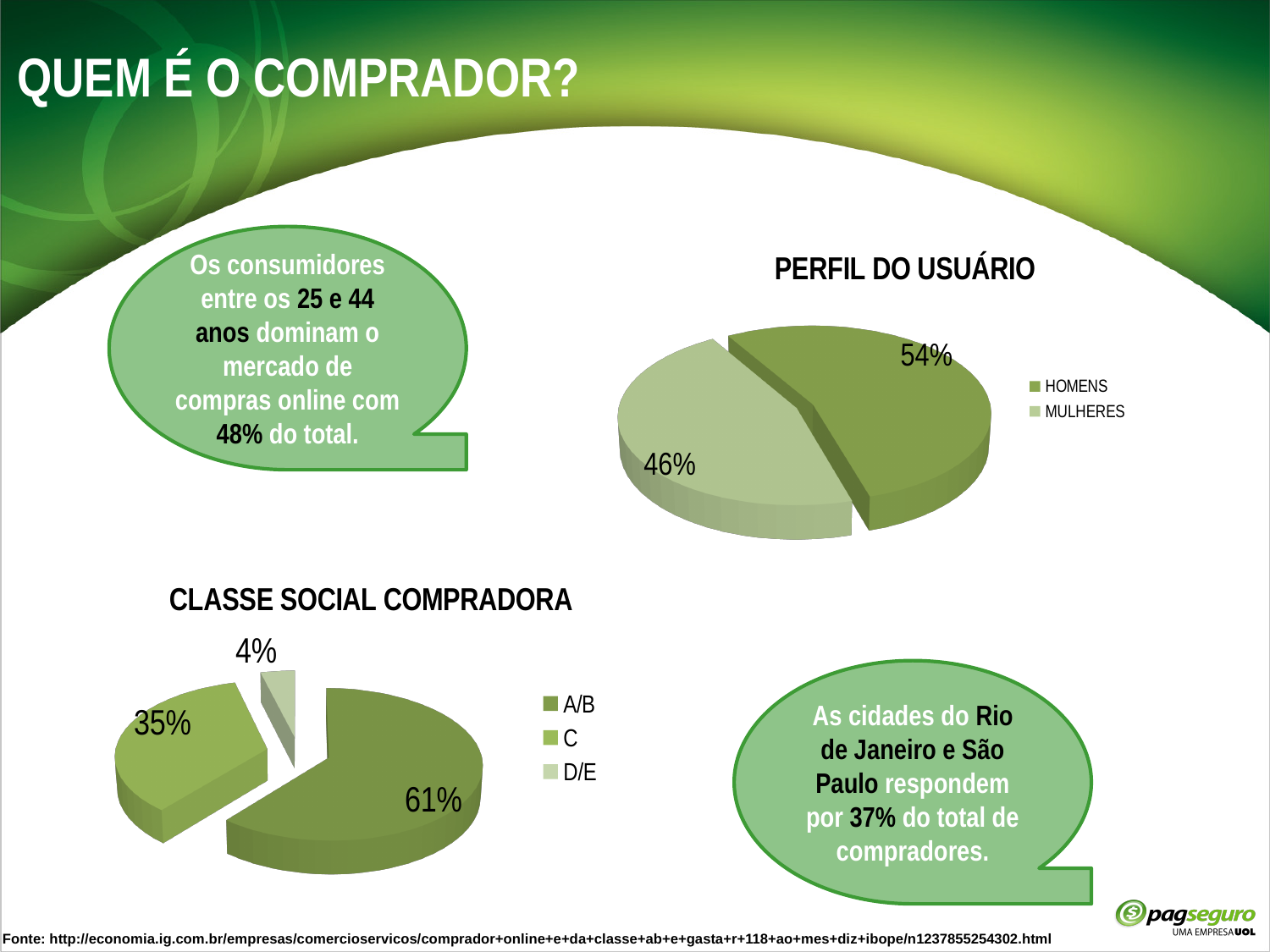
In the PERFIL DO USUÁRIO chart, what share is labelled for MULHERES? 46% In the CLASSE SOCIAL COMPRADORA chart, which category has the smallest slice? D/E In the PERFIL DO USUÁRIO chart, which category has the larger slice? HOMENS In the CLASSE SOCIAL COMPRADORA chart, which is larger, A/B or C? A/B How many entries does the legend of the PERFIL DO USUÁRIO chart list? 2 In the CLASSE SOCIAL COMPRADORA chart, what share is labelled for A/B? 61% In the CLASSE SOCIAL COMPRADORA chart, what share is labelled for C? 35% How many slices does the CLASSE SOCIAL COMPRADORA chart have? 3 In the PERFIL DO USUÁRIO chart, what is the difference in percentage points between HOMENS and MULHERES? 8 What kind of chart is PERFIL DO USUÁRIO? Pie chart In the CLASSE SOCIAL COMPRADORA chart, what is the difference in percentage points between C and D/E? 31 In the PERFIL DO USUÁRIO chart, what share is labelled for HOMENS? 54%